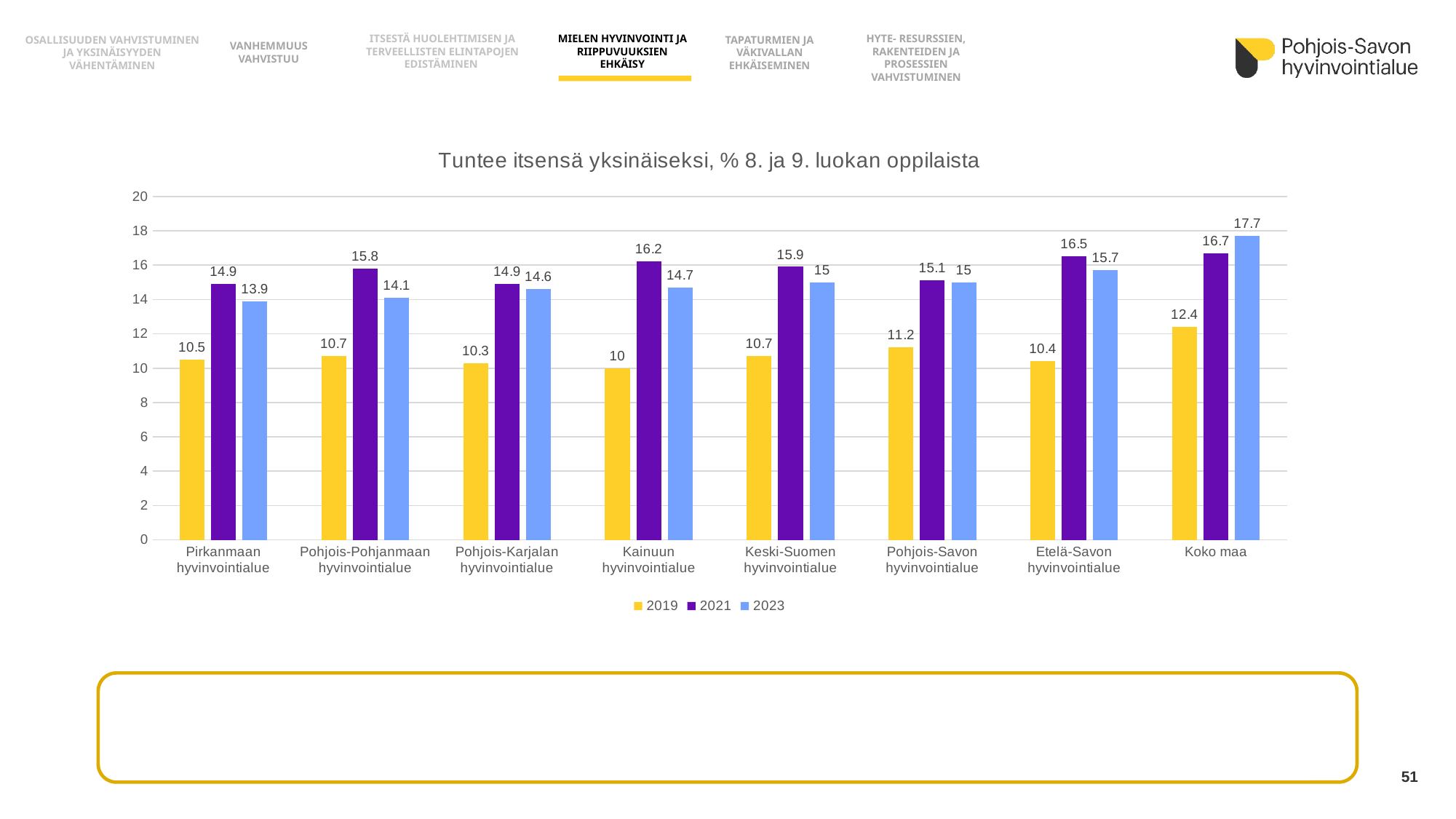
Which category has the highest 2023 value? Koko maa What is the title of the chart? Tuntee itsensä yksinäiseksi, % 8. ja 9. luokan oppilaista What kind of chart is shown on the slide? Bar chart What is the 2021 value for Etelä-Savon hyvinvointialue? 16.5 Which is larger for Pohjois-Pohjanmaan hyvinvointialue, the 2021 value or the 2023 value? 2021 What is the 2019 value for Kainuun hyvinvointialue? 10 Which category has the lowest 2019 value? Kainuun hyvinvointialue What is the difference between the 2021 and 2019 values for Pirkanmaan hyvinvointialue? 4.4 How many series does the legend list? 3 What is the 2023 value for Pohjois-Savon hyvinvointialue? 15 Which series is shown in yellow? 2019 How many categories are shown on the x axis? 8